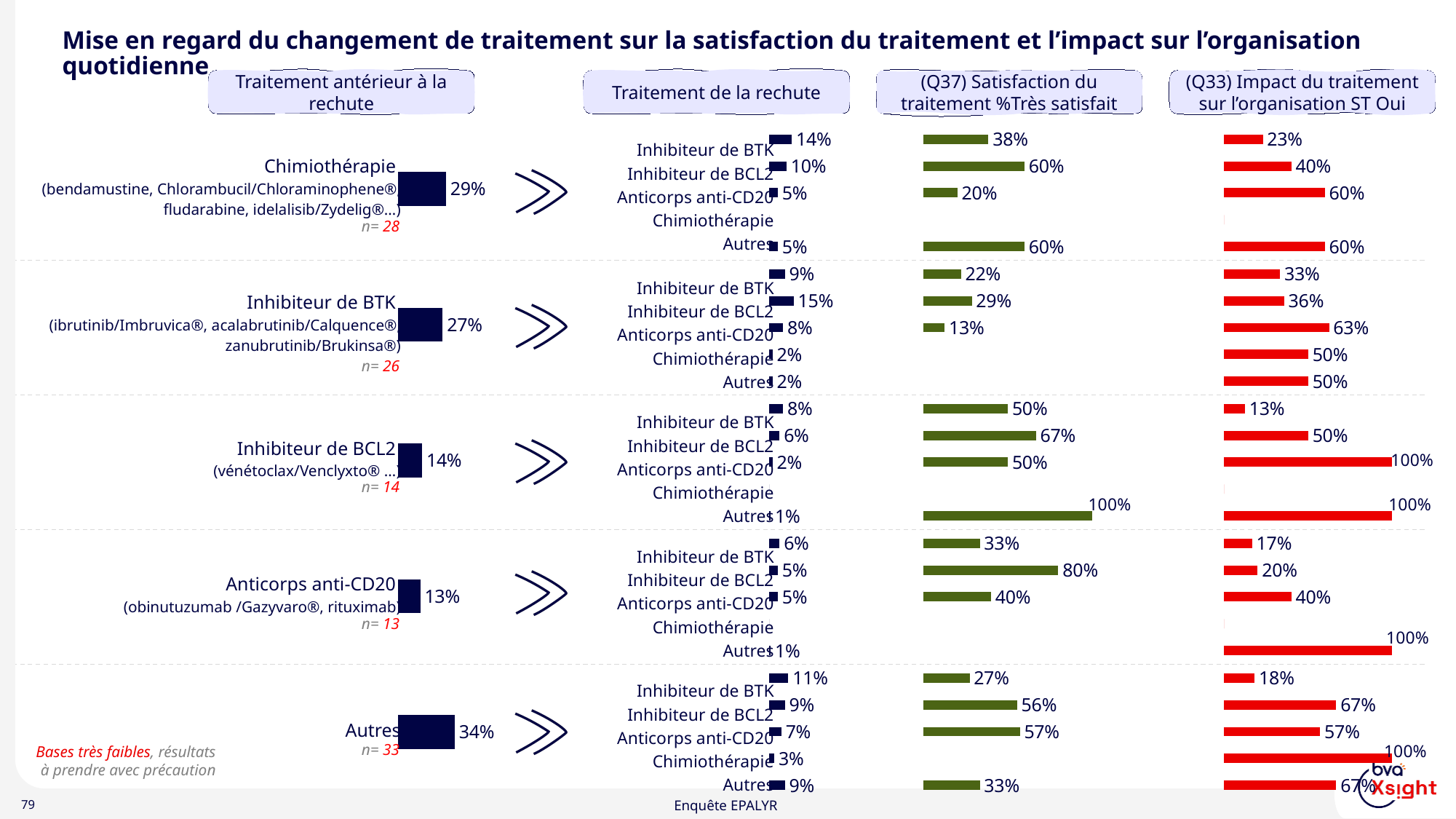
In the '(Q33) Impact du traitement sur l'organisation ST Oui' chart for the Inhibiteur de BTK row, which is larger: Anticorps anti-CD20 or Inhibiteur de BTK? Anticorps anti-CD20 What kind of chart is the 'Traitement antérieur à la rechute' chart? Bar chart In the 'Traitement de la rechute' chart for the Chimiothérapie row, what is the value for Inhibiteur de BTK? 14% In the 'Traitement antérieur à la rechute' chart, what is the difference between Chimiothérapie and Inhibiteur de BTK? 2 percentage points What colour are the bars in the '(Q33) Impact du traitement sur l'organisation ST Oui' charts? Red How many categories are shown in the 'Traitement antérieur à la rechute' chart? 5 In the '(Q37) Satisfaction du traitement %Très satisfait' chart for the Anticorps anti-CD20 row, which relapse treatment has the highest value? Inhibiteur de BCL2 In the 'Traitement antérieur à la rechute' chart, which category has the highest value? Autres In the '(Q33) Impact du traitement sur l'organisation ST Oui' chart for the Chimiothérapie row, what is the value for Anticorps anti-CD20? 60% In the '(Q37) Satisfaction du traitement %Très satisfait' chart for the Inhibiteur de BCL2 row, what is the value for Autres? 100% In the 'Traitement antérieur à la rechute' chart, what is the value for Autres? 34% In the 'Traitement antérieur à la rechute' chart, which category has the lowest value? Anticorps anti-CD20